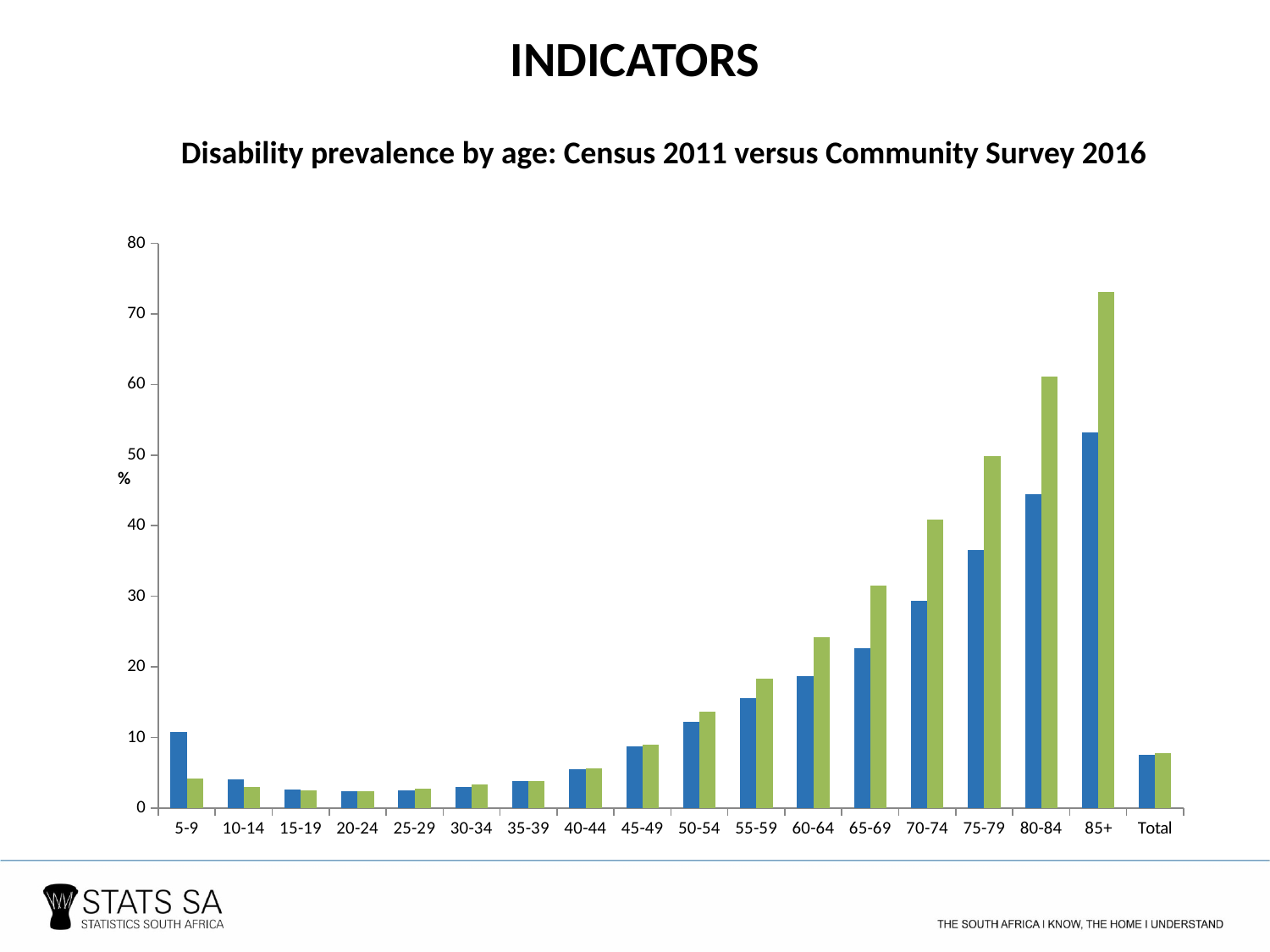
For the 5-9 age group, which bar is taller, the blue one or the green one? blue Which age group has the tallest blue bar? 85+ What label is shown on the y axis of the chart? % How many categories are shown on the x axis of the chart? 18 Which age group has the tallest green bar? 85+ Is the blue bar for Total greater or less than 10? less Do the green bars rise or fall from the 20-24 age group to the 85+ age group? rise What is the title of the chart? Disability prevalence by age: Census 2011 versus Community Survey 2016 Is the blue bar for 80-84 greater or less than 50? less Is the blue bar for 85+ greater or less than 50? greater What kind of chart is shown on the slide? bar chart